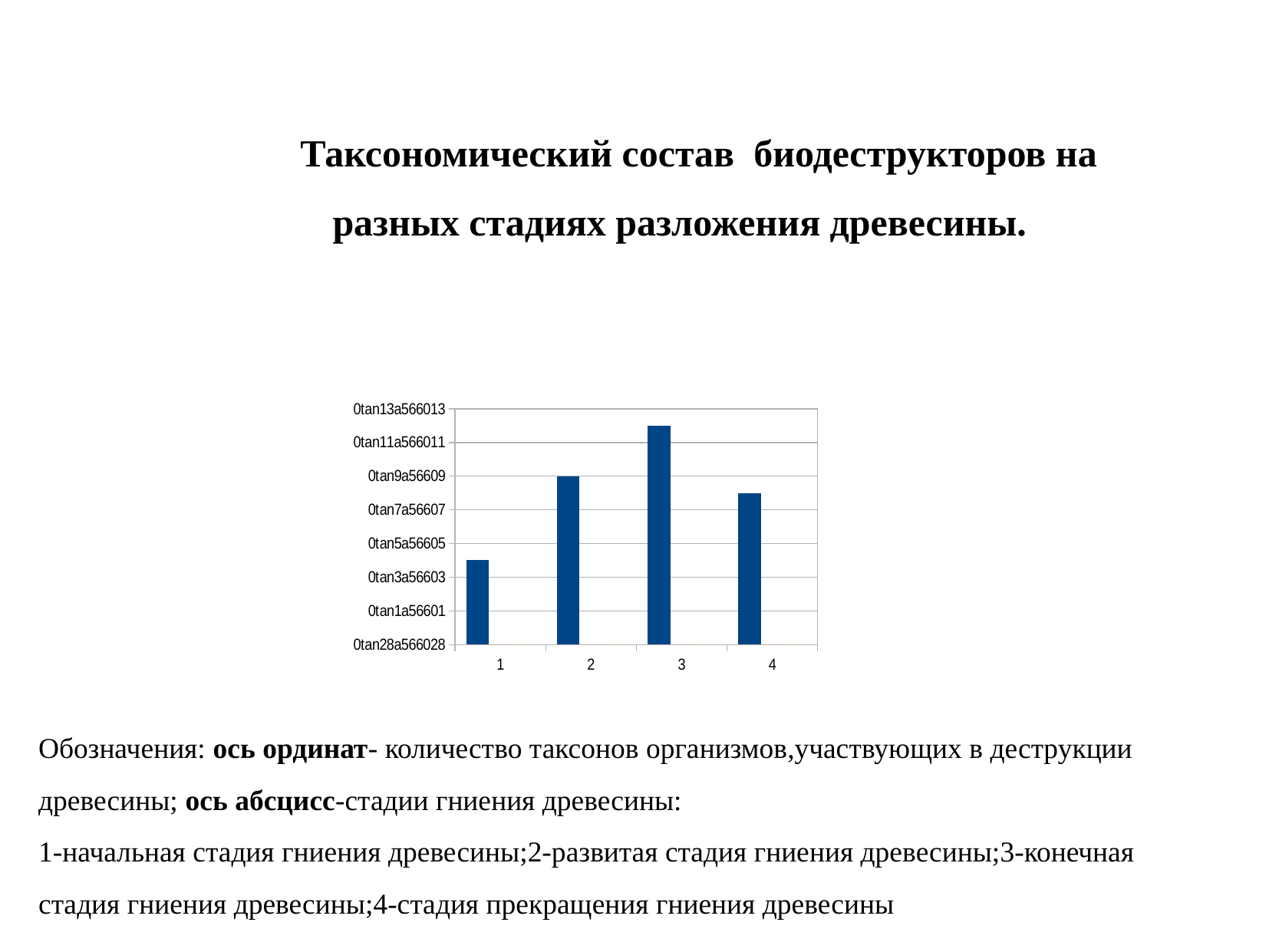
Which has the taller bar, stage 2 or stage 3? 3 Do the bars rise or fall from stage 3 to stage 4? fall Do the bars rise or fall from stage 1 to stage 3? rise What kind of chart is shown on the slide? bar chart Which stage has the highest bar in the chart? 3 Which stage has the lowest bar in the chart? 1 Which has the taller bar, stage 1 or stage 4? 4 What colour are the bars in the chart? dark blue How many categories (stages) are plotted on the x axis of the chart? 4 What is the title of the slide containing the chart? Таксономический состав биодеструкторов на разных стадиях разложения древесины. Which has the taller bar, stage 2 or stage 4? 2